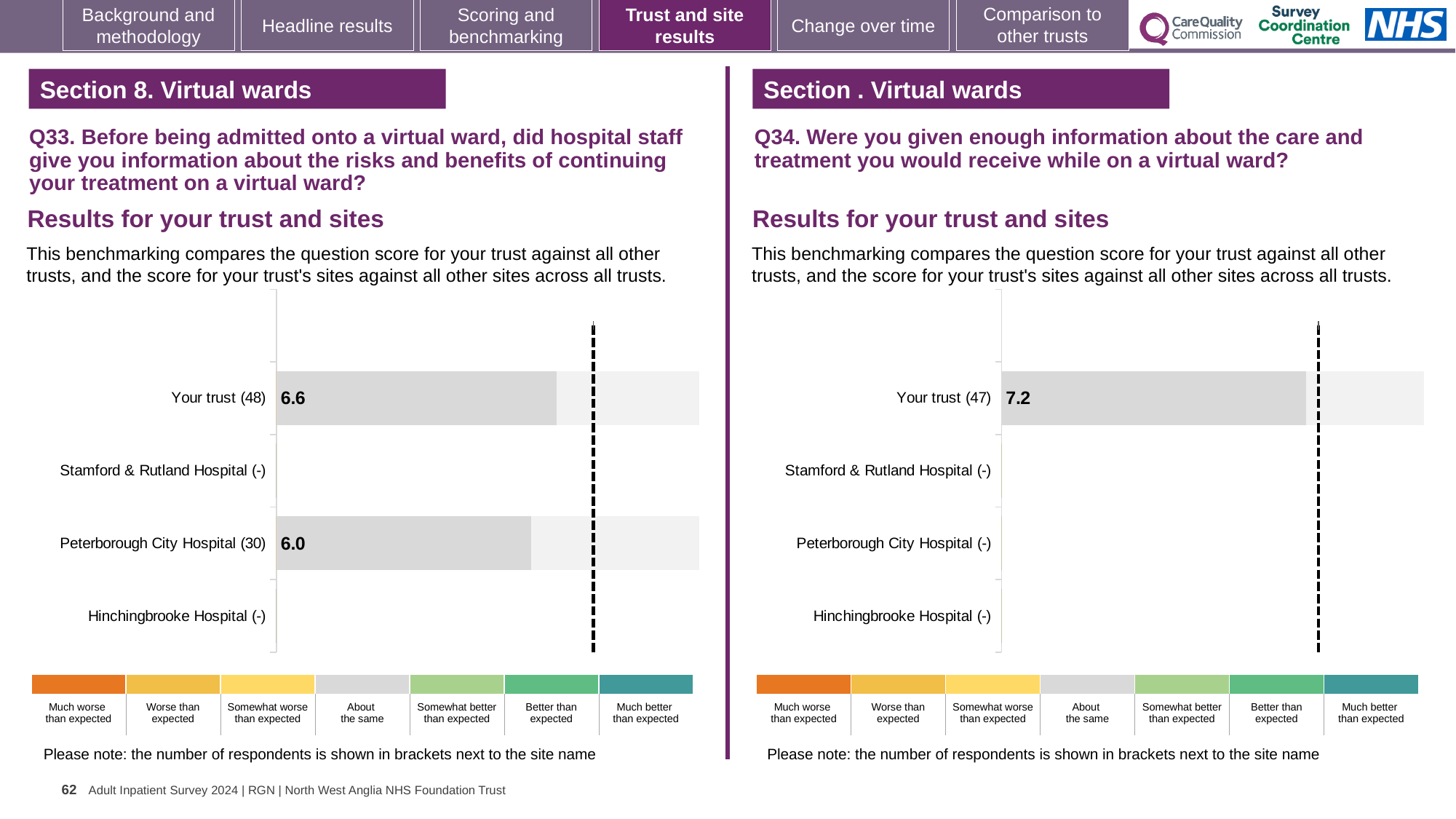
How many categories on the Q34 chart (right) show a dash (-) instead of a respondent count? 3 What kind of chart is the Q33 chart (left)? Bar chart On the Q33 chart (left), which has the higher score, Your trust or Peterborough City Hospital? Your trust On the Q33 chart (left), what is the score for Peterborough City Hospital? 6.0 On the Q34 chart (right), what is the score for Your trust? 7.2 On the Q33 chart (left), how many respondents are shown in brackets for Your trust? 48 How many categories (rows) are listed on the Q34 chart (right)? 4 On the Q33 chart (left), which category has the lowest printed score? Peterborough City Hospital On the Q34 chart (right), how many respondents are shown in brackets for Your trust? 47 On the Q33 chart (left), what is the score for Your trust? 6.6 On the Q33 chart (left), how many respondents are shown in brackets for Peterborough City Hospital? 30 On the Q33 chart (left), what is the difference between the score for Your trust and the score for Peterborough City Hospital? 0.6